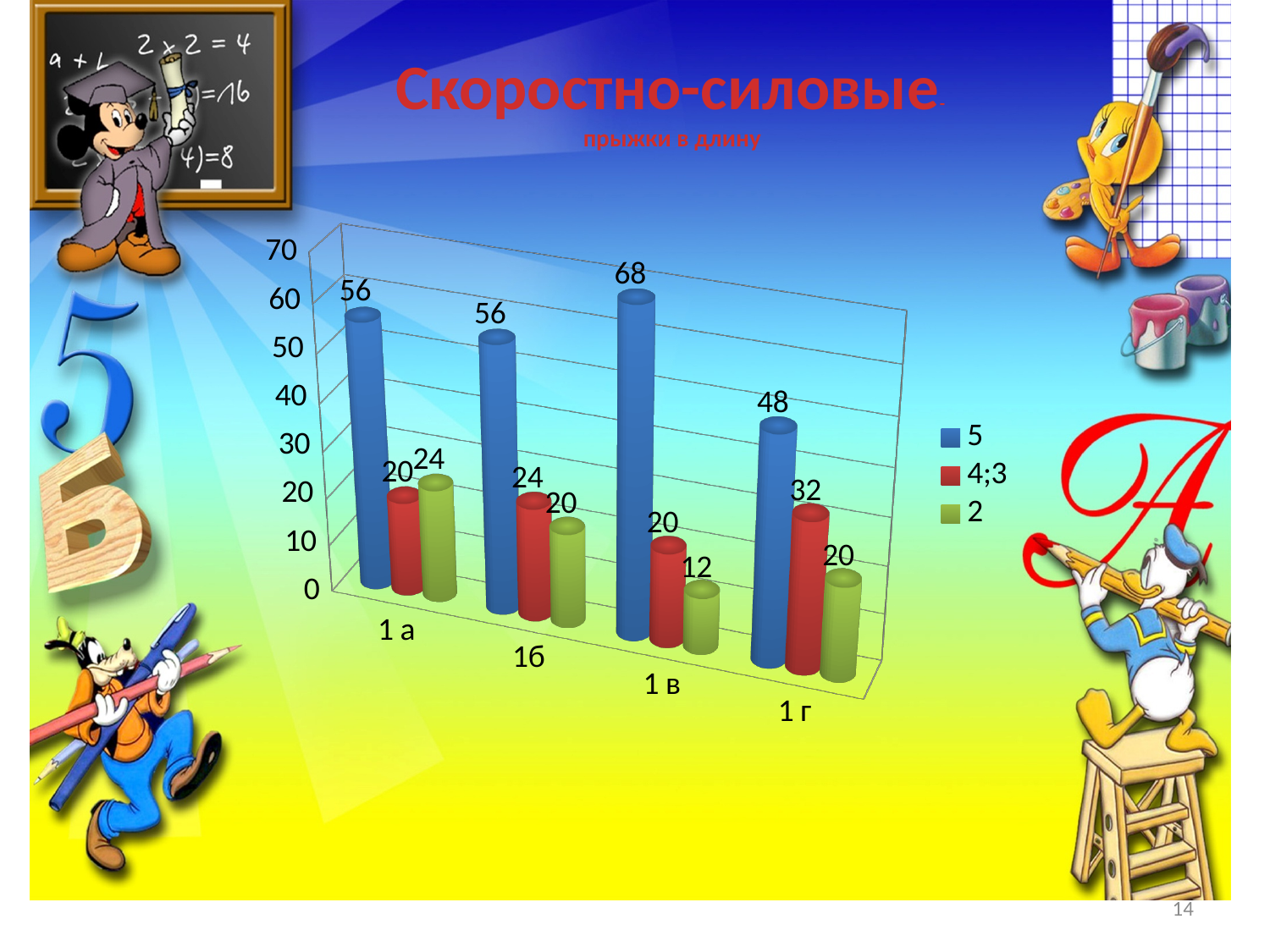
Which is larger: the series "4;3" value for "1 г" or for "1 а"? 1 г How many categories are shown on the x axis? 4 What is the difference between the series "5" values for "1 в" and "1 г"? 20 What is the difference between the series "2" values for "1 а" and "1 в"? 12 What is the value of series "2" for category "1 в"? 12 What is the value of series "4;3" for category "1 г"? 32 What is the main title of the chart on the slide? Скоростно-силовые Which category has the lowest value for series "5"? 1 г Which category has the highest value for series "5"? 1 в How many series does the legend list? 3 What kind of chart is shown on the slide? bar chart What is the value of series "5" for category "1 в"? 68